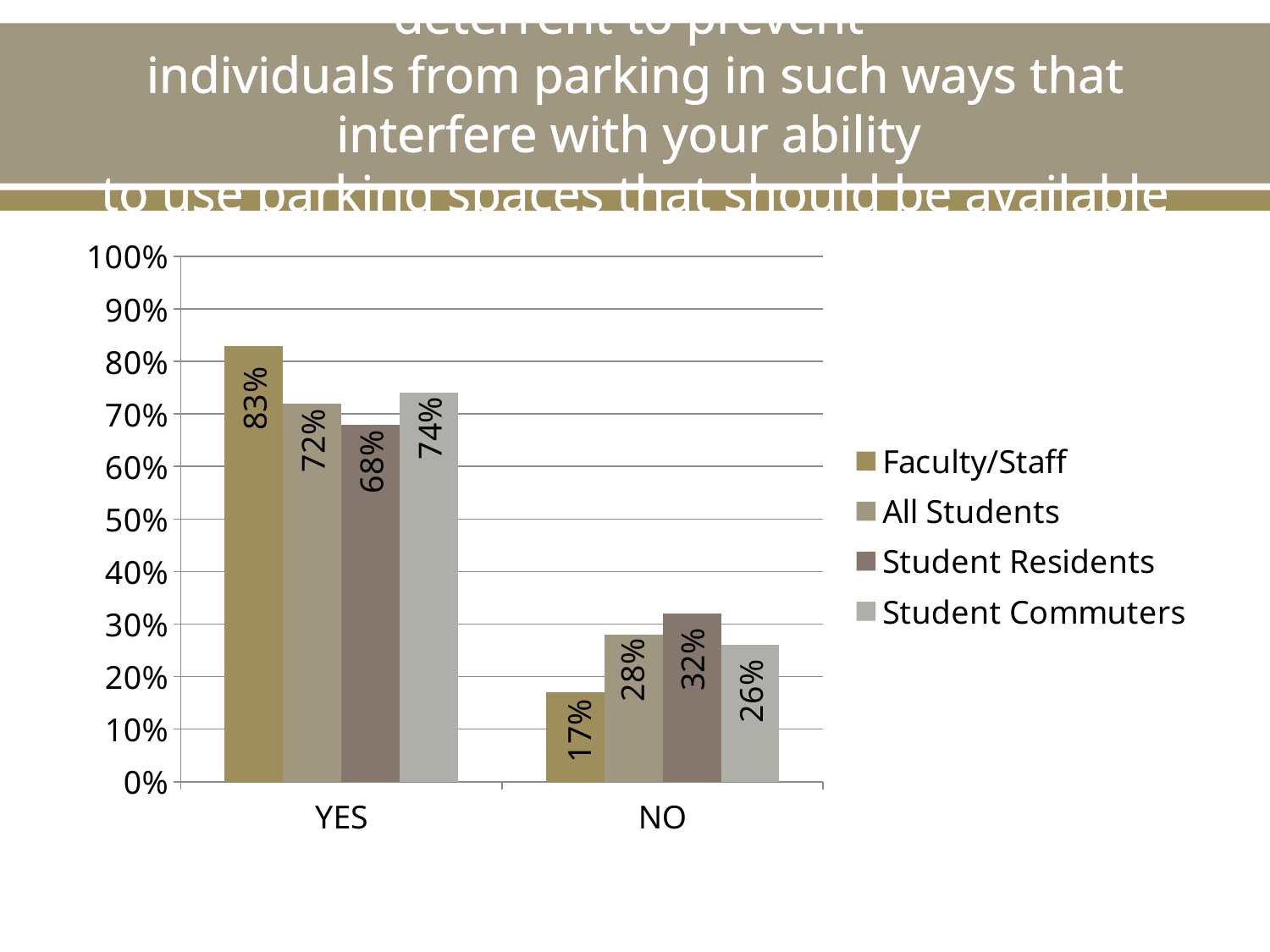
What is the value for Student Commuters in the YES category? 74% What kind of chart is shown on the slide? Bar chart Which series has the highest value in the YES category? Faculty/Staff How many series does the legend list? 4 Is the value for Student Residents in the YES category greater or less than 60%? greater Which series has the lowest value in the NO category? Faculty/Staff What is the value for All Students in the NO category? 28% Which is larger in the NO category: All Students or Student Commuters? All Students What is the difference between the Faculty/Staff and Student Residents values in the YES category? 15% What is the value for Faculty/Staff in the YES category? 83% What is the value for Student Residents in the NO category? 32% How many categories are shown on the x axis? 2